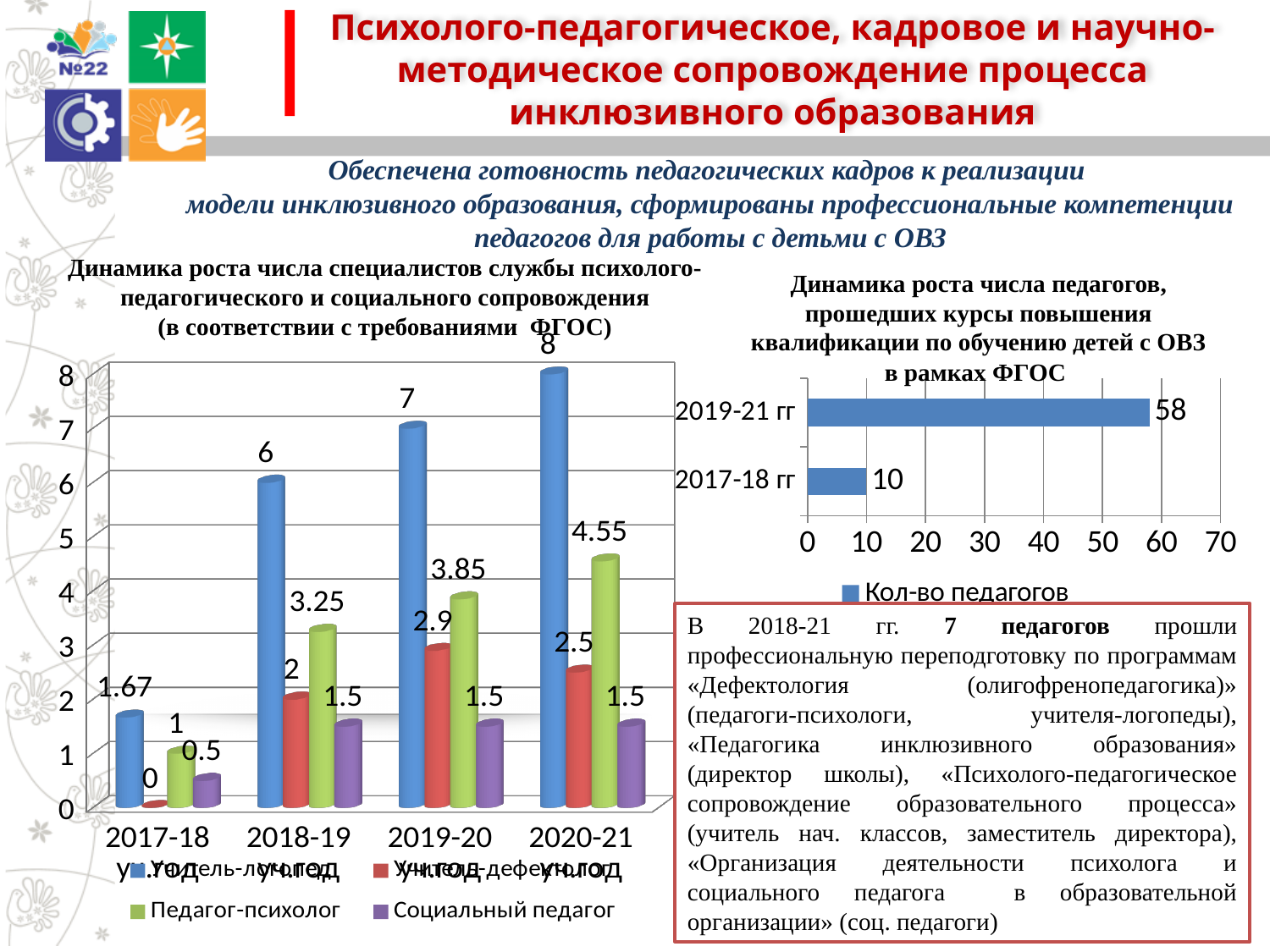
In the left chart (Динамика роста числа специалистов службы психолого-педагогического и социального сопровождения), does the value for Учитель-логопед rise or fall from 2017-18 уч.год to 2020-21 уч.год? Rise In the left chart (Динамика роста числа специалистов службы психолого-педагогического и социального сопровождения), in which year is the value for Учитель-логопед highest? 2020-21 уч.год How many series does the legend of the left chart (Динамика роста числа специалистов службы психолого-педагогического и социального сопровождения) list? 4 In the left chart (Динамика роста числа специалистов службы психолого-педагогического и социального сопровождения), what is the value for Педагог-психолог in 2019-20 уч.год? 3.85 What kind of chart is the right chart (Динамика роста числа педагогов, прошедших курсы повышения квалификации)? Bar chart In the right chart (Динамика роста числа педагогов, прошедших курсы повышения квалификации), what is the value for 2017-18 гг? 10 In the left chart (Динамика роста числа специалистов службы психолого-педагогического и социального сопровождения), what is the value for Учитель-логопед in 2020-21 уч.год? 8 In the left chart (Динамика роста числа специалистов службы психолого-педагогического и социального сопровождения), what is the value for Учитель-дефектолог in 2017-18 уч.год? 0 In the right chart (Динамика роста числа педагогов, прошедших курсы повышения квалификации), what is the difference between the values for 2019-21 гг and 2017-18 гг? 48 In the left chart (Динамика роста числа специалистов службы психолого-педагогического и социального сопровождения), in which year is the value for Педагог-психолог lowest? 2017-18 уч.год In the right chart (Динамика роста числа педагогов, прошедших курсы повышения квалификации), what is the value for 2019-21 гг? 58 In the left chart (Динамика роста числа специалистов службы психолого-педагогического и социального сопровождения), what is the difference between the Учитель-дефектолог values for 2019-20 уч.год and 2020-21 уч.год? 0.4